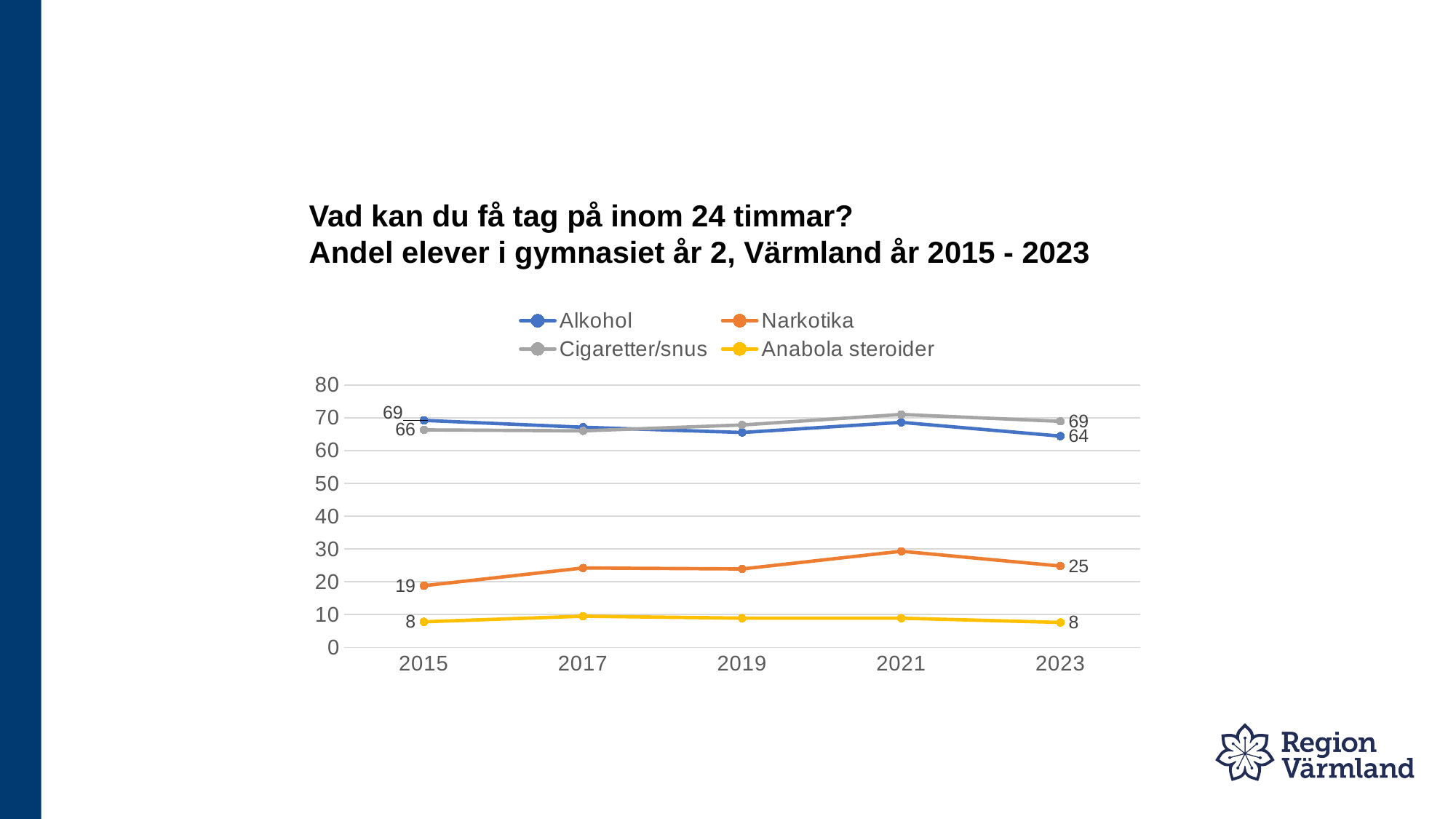
What is the value for Anabola steroider in 2015? 8 What is the value for Cigaretter/snus in 2023? 69 What is the value for Narkotika in 2023? 25 In 2023, which is higher: Alkohol or Cigaretter/snus? Cigaretter/snus Is the value for Narkotika in 2021 greater or less than 20? greater How many series does the legend list? 4 What is the value for Alkohol in 2015? 69 How many years are shown on the x axis? 5 What is the difference between the Narkotika values in 2023 and 2015? 6 By how much did the value for Alkohol fall from 2015 to 2023? 5 Which series has the lowest value in 2023? Anabola steroider What kind of chart is shown on the slide? line chart